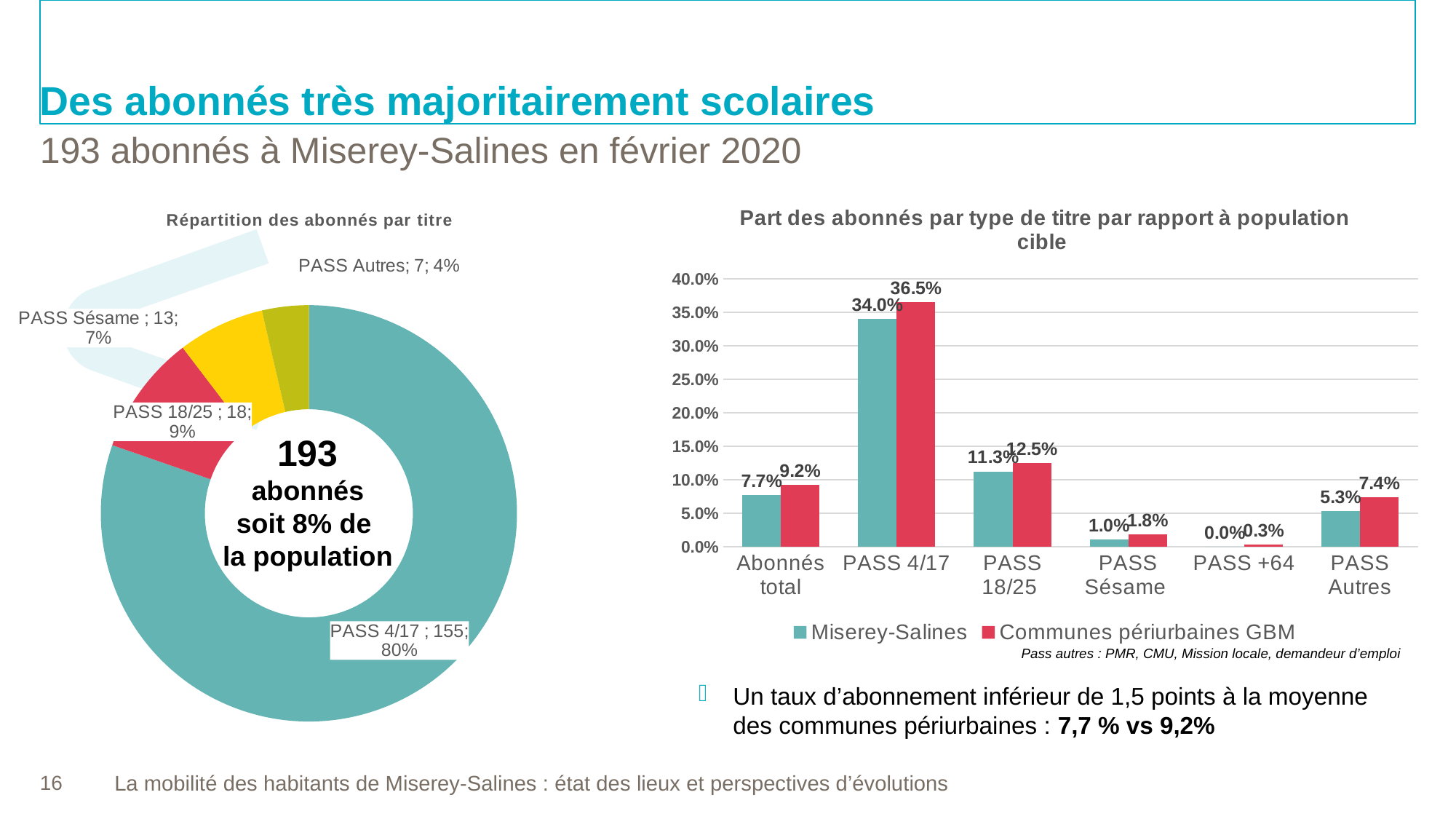
What kind of chart is 'Répartition des abonnés par titre'? Donut (pie) chart In the chart 'Part des abonnés par type de titre par rapport à population cible', what is the value for PASS 4/17 for Miserey-Salines? 34.0% In the chart 'Part des abonnés par type de titre par rapport à population cible', what is the value for PASS Autres for Communes périurbaines GBM? 7.4% In the chart 'Répartition des abonnés par titre', how many title categories are shown? 4 In the chart 'Part des abonnés par type de titre par rapport à population cible', is the value for PASS 18/25 for Miserey-Salines greater or less than 10.0%? greater In the chart 'Répartition des abonnés par titre', which title has the fewest subscribers? PASS Autres In the chart 'Part des abonnés par type de titre par rapport à population cible', how many series does the legend list? 2 In the chart 'Part des abonnés par type de titre par rapport à population cible', what is the difference between Communes périurbaines GBM and Miserey-Salines for Abonnés total? 1.5% In the chart 'Répartition des abonnés par titre', what share of subscribers hold a PASS 18/25? 9% In the chart 'Répartition des abonnés par titre', how many subscribers hold a PASS 4/17? 155 What kind of chart is 'Part des abonnés par type de titre par rapport à population cible'? Bar chart In the chart 'Part des abonnés par type de titre par rapport à population cible', which category has the highest value for Miserey-Salines? PASS 4/17